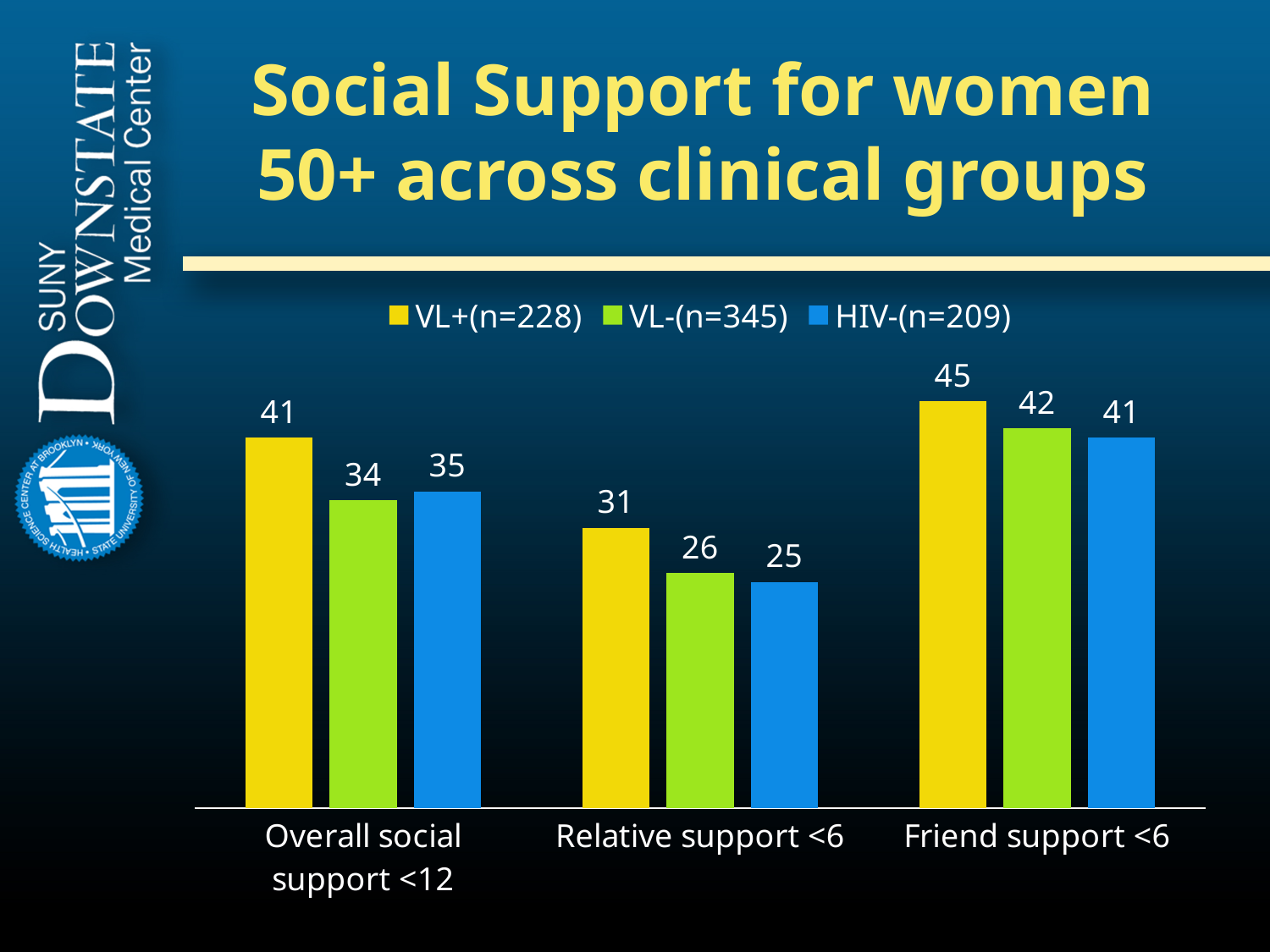
What is the value for VL+(n=228) in the Overall social support <12 category? 41 What is the difference between the VL+(n=228) and VL-(n=345) values in the Overall social support <12 category? 7 What kind of chart is shown on the slide? Bar chart What is the value for HIV-(n=209) in the Relative support <6 category? 25 In the Relative support <6 category, which is larger: the VL+(n=228) value or the VL-(n=345) value? VL+(n=228) What is the title of the slide? Social Support for women 50+ across clinical groups How many series does the legend list? 3 How many categories are shown on the x axis? 3 What is the value for VL-(n=345) in the Friend support <6 category? 42 Which category has the highest value for the VL+(n=228) series? Friend support <6 Which category has the lowest value for the HIV-(n=209) series? Relative support <6 Which colour represents the HIV-(n=209) series? Blue